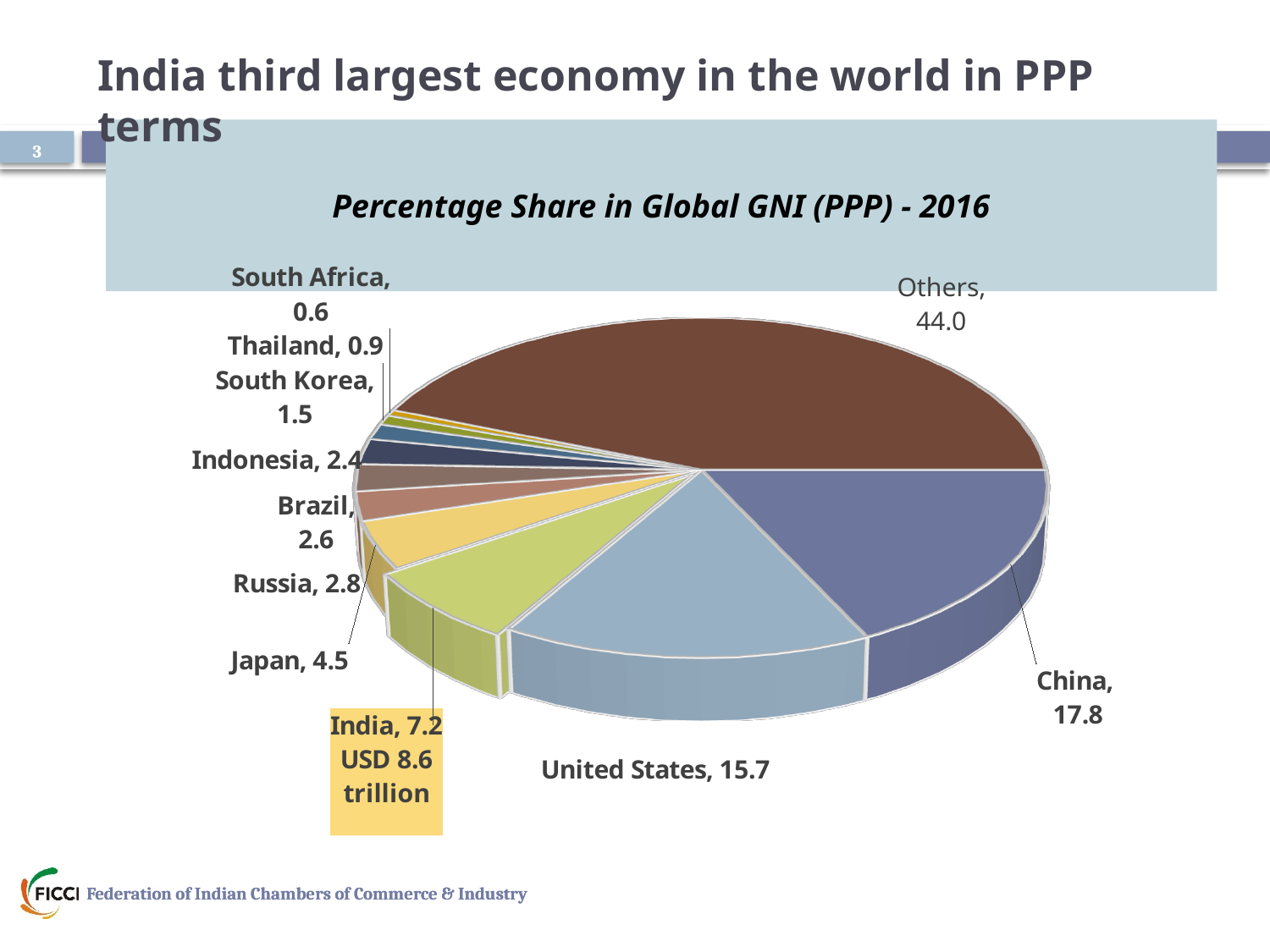
What is the percentage share for India? 7.2 Which country has the smallest share in the pie chart? South Africa What is the difference between China's share and the United States' share? 2.1 What type of chart is shown on the slide? Pie chart What is the percentage share for Japan? 4.5 What is the percentage share for Indonesia? 2.4 What is the percentage share for the United States? 15.7 Which has a larger share, Russia or Brazil? Russia What is the percentage share for China? 17.8 What is the title of the pie chart? Percentage Share in Global GNI (PPP) - 2016 Which slice has the largest share in the pie chart? Others How many slices does the pie chart have? 11